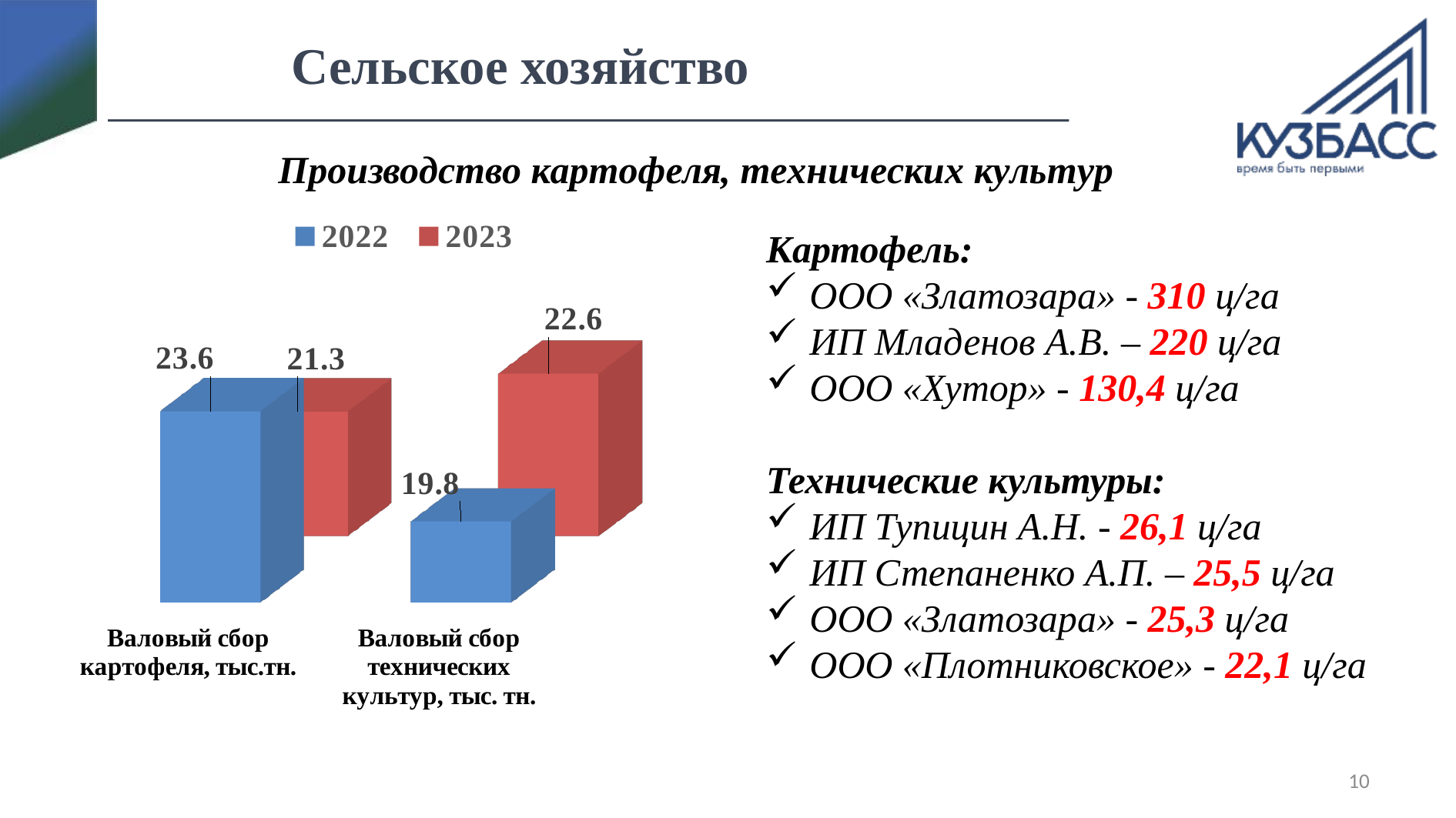
What is the value for 2022 in the category "Валовый сбор технических культур, тыс. тн."? 19.8 What kind of chart is shown on the slide? Bar chart Which series has the higher value in the category "Валовый сбор технических культур, тыс. тн.", 2022 or 2023? 2023 How many categories are shown on the chart's x axis? 2 What is the difference between the 2023 and 2022 values for "Валовый сбор технических культур, тыс. тн."? 2.8 Which bar in the chart has the lowest value? 2022, Валовый сбор технических культур, тыс. тн. What is the value for 2023 in the category "Валовый сбор картофеля, тыс.тн."? 21.3 What is the difference between the 2022 and 2023 values for "Валовый сбор картофеля, тыс.тн."? 2.3 What is the value for 2022 in the category "Валовый сбор картофеля, тыс.тн."? 23.6 What is the value for 2023 in the category "Валовый сбор технических культур, тыс. тн."? 22.6 How many series does the chart legend list? 2 Which series has the higher value in the category "Валовый сбор картофеля, тыс.тн.", 2022 or 2023? 2022